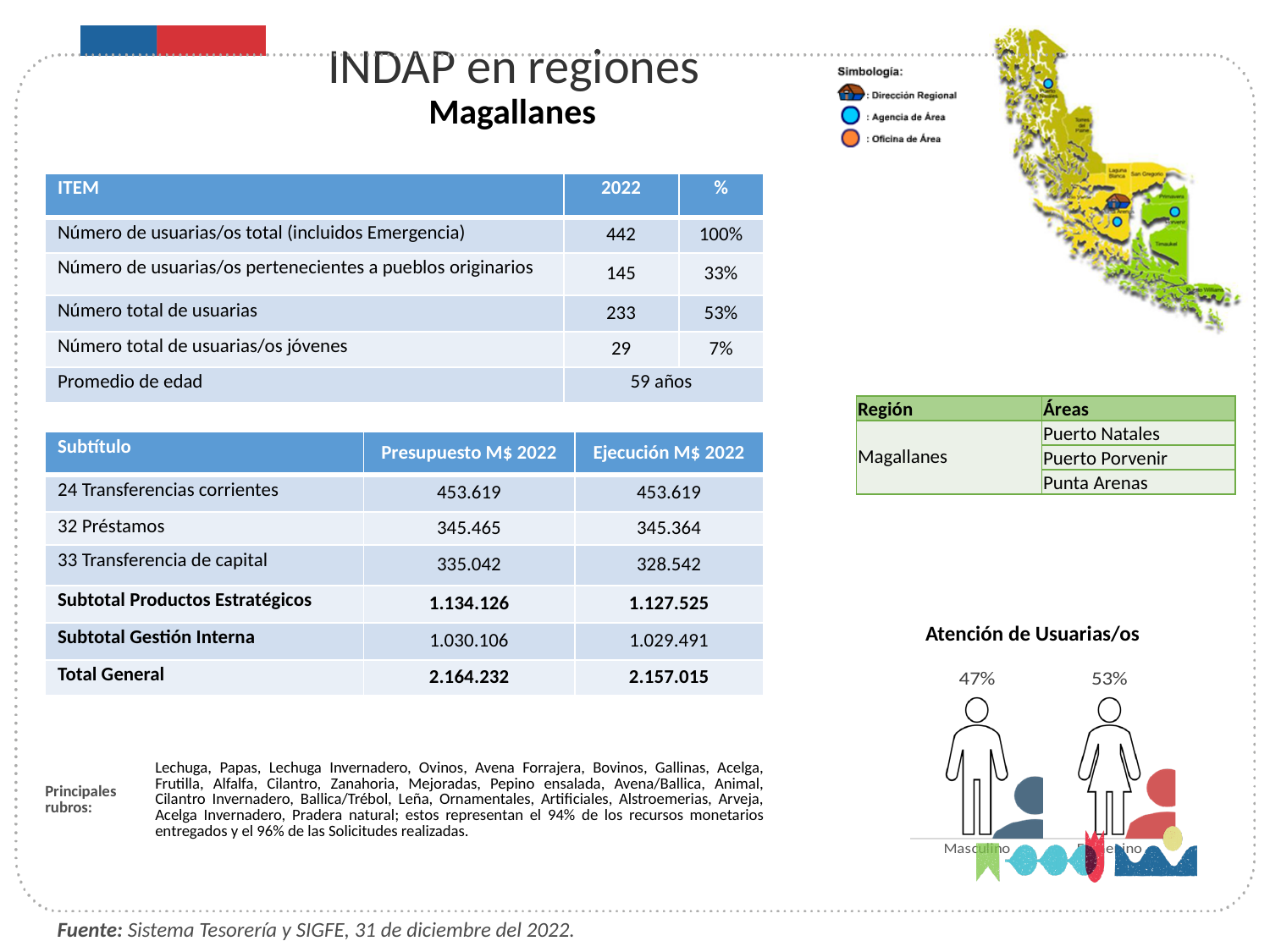
In the 'Atención de Usuarias/os' chart, what is the total of the Masculino and Femenino values? 100% In the 'Atención de Usuarias/os' chart, what is the value for Femenino? 53% In the 'Atención de Usuarias/os' chart, which is larger, the value for Masculino or the value for Femenino? Femenino In the 'Atención de Usuarias/os' chart, what is the value for Masculino? 47% In the 'Atención de Usuarias/os' chart, what is the difference between the Femenino and Masculino values? 6% How many categories are shown in the 'Atención de Usuarias/os' chart? 2 In the 'Atención de Usuarias/os' chart, which category has the highest value? Femenino What is the title of the chart at the bottom right of the slide? Atención de Usuarias/os In the 'Atención de Usuarias/os' chart, which category has the lowest value? Masculino